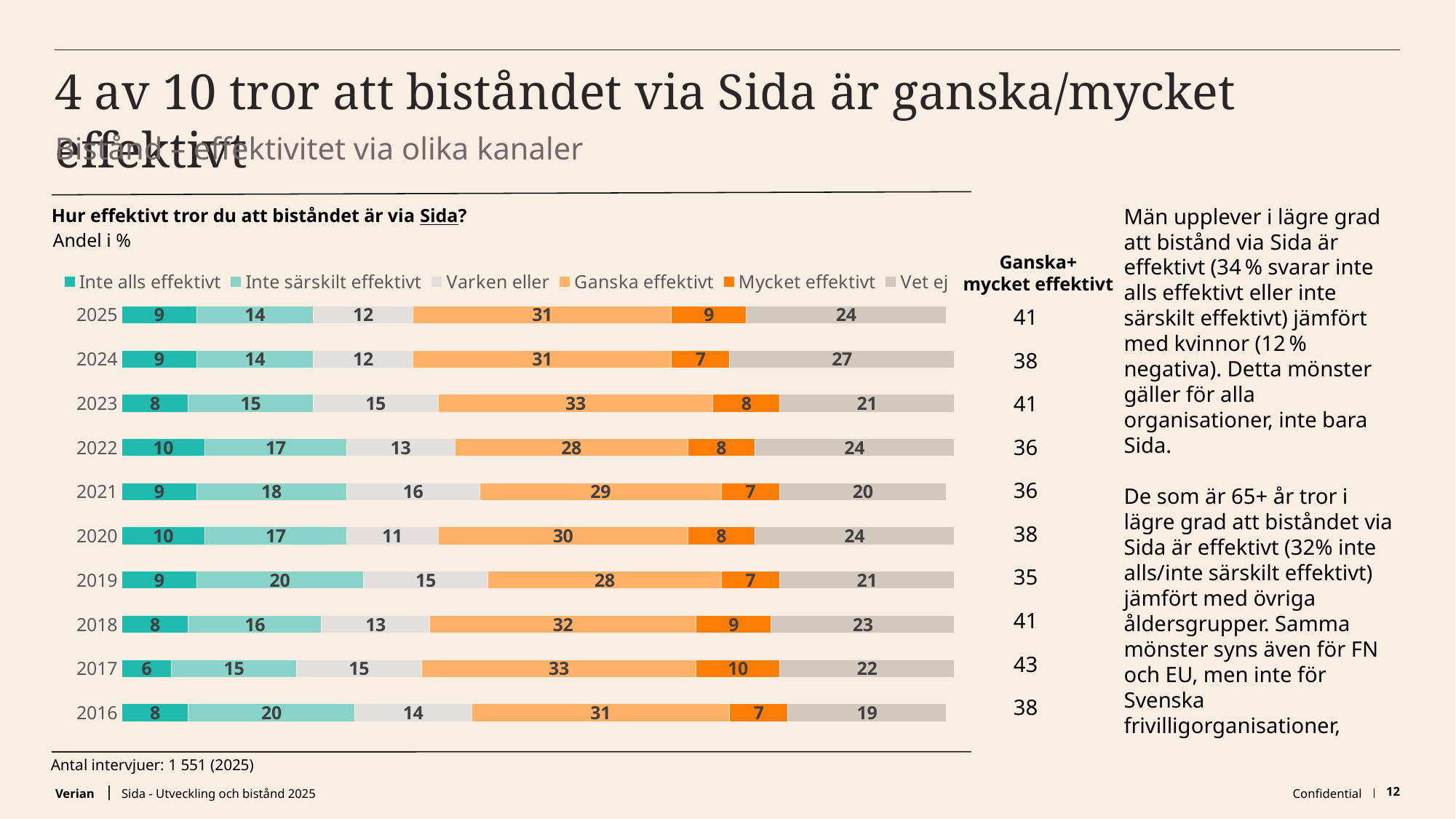
What kind of chart is shown on the slide? Stacked bar chart How many series does the legend list? 6 Which year has the larger value for "Inte särskilt effektivt", 2019 or 2018? 2019 What is the value for "Ganska effektivt" in 2025? 31 What is the value for "Mycket effektivt" in 2017? 10 What is the value for "Vet ej" in 2024? 27 What is the "Ganska+ mycket effektivt" figure shown for 2017? 43 What is the difference between the "Vet ej" values for 2024 and 2025? 3 Which year has the highest value for "Mycket effektivt"? 2017 What is the total of the printed values in the 2025 bar? 99 How many years are shown in the chart? 10 Which year has the lowest value for "Inte alls effektivt"? 2017